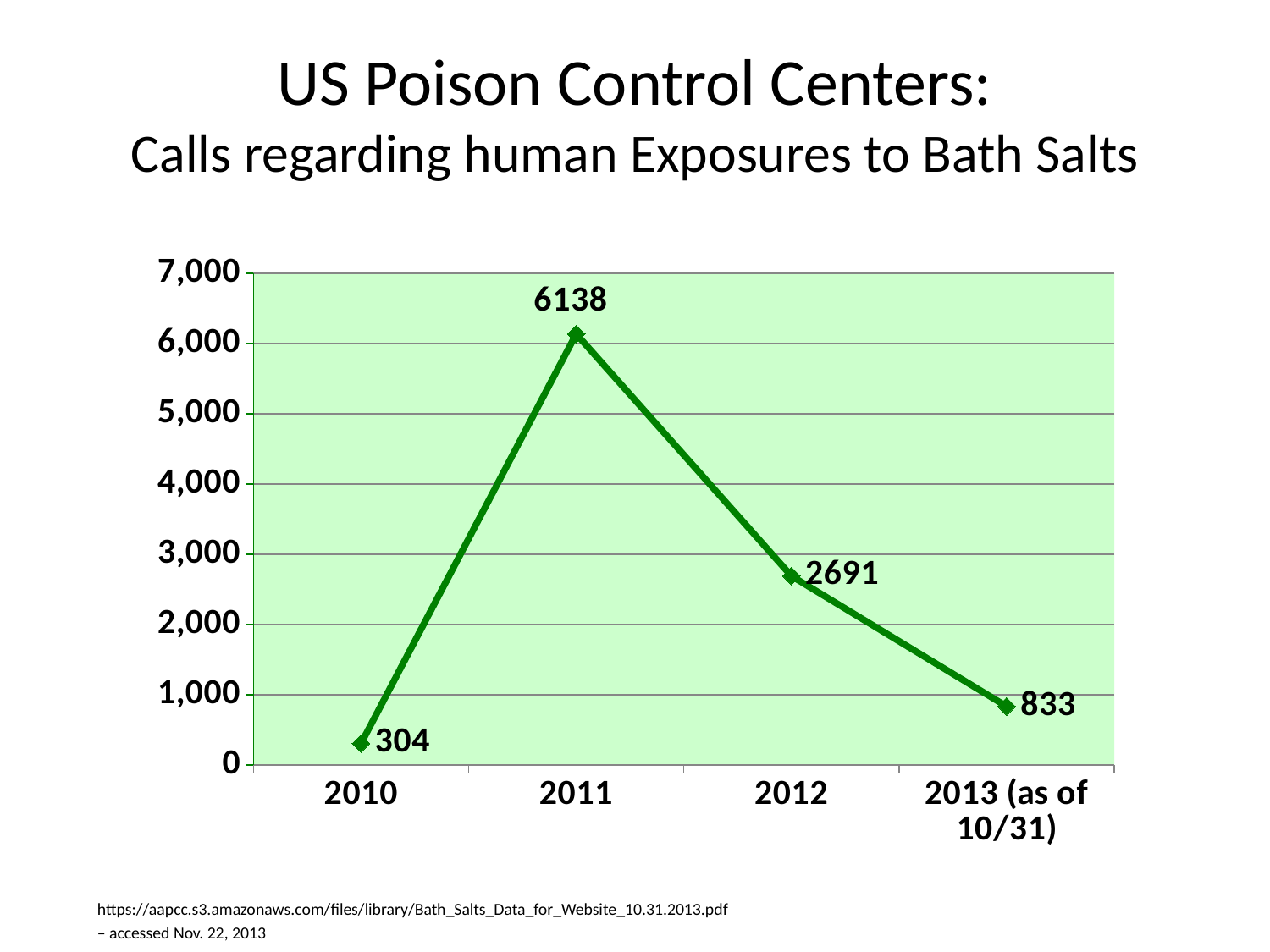
How many data points are plotted on the chart? 4 What is the number of calls in 2011? 6138 Which has more calls, 2012 or 2013 (as of 10/31)? 2012 Which year has the lowest number of calls? 2010 What kind of chart is shown on the slide? line chart What is the number of calls for 2013 (as of 10/31)? 833 What is the number of calls in 2010? 304 Which year has the highest number of calls? 2011 Is the value for 2012 greater or less than 3,000? less Do the values rise or fall from 2011 to 2013 (as of 10/31)? fall What is the number of calls in 2012? 2691 What is the difference between the number of calls in 2011 and 2012? 3447